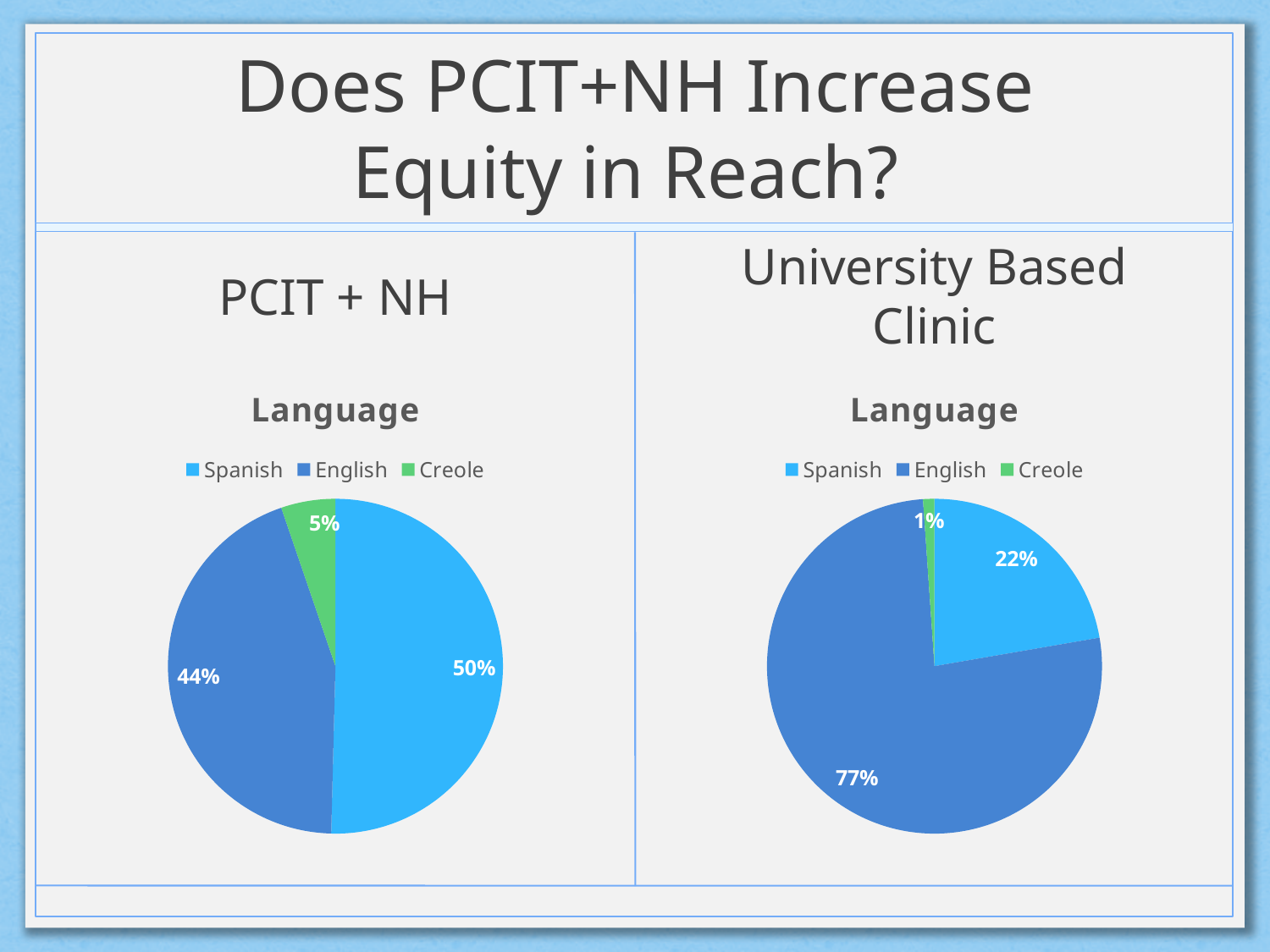
How many categories does the legend of the PCIT + NH pie chart on the left list? 3 In the University Based Clinic pie chart on the right, what share is Creole? 1% In the PCIT + NH pie chart on the left, what share is Creole? 5% In the PCIT + NH pie chart on the left, what share is Spanish? 50% In the University Based Clinic pie chart on the right, what share is Spanish? 22% In the PCIT + NH pie chart on the left, which language has the largest slice? Spanish In the University Based Clinic pie chart on the right, what share is English? 77% In the PCIT + NH pie chart on the left, what share is English? 44% In the University Based Clinic pie chart on the right, what is the difference between the English and Spanish shares? 55% Which chart has the larger Spanish share, the PCIT + NH chart on the left or the University Based Clinic chart on the right? PCIT + NH What type of chart is used on the left under PCIT + NH? Pie chart In the University Based Clinic pie chart on the right, which language has the smallest slice? Creole